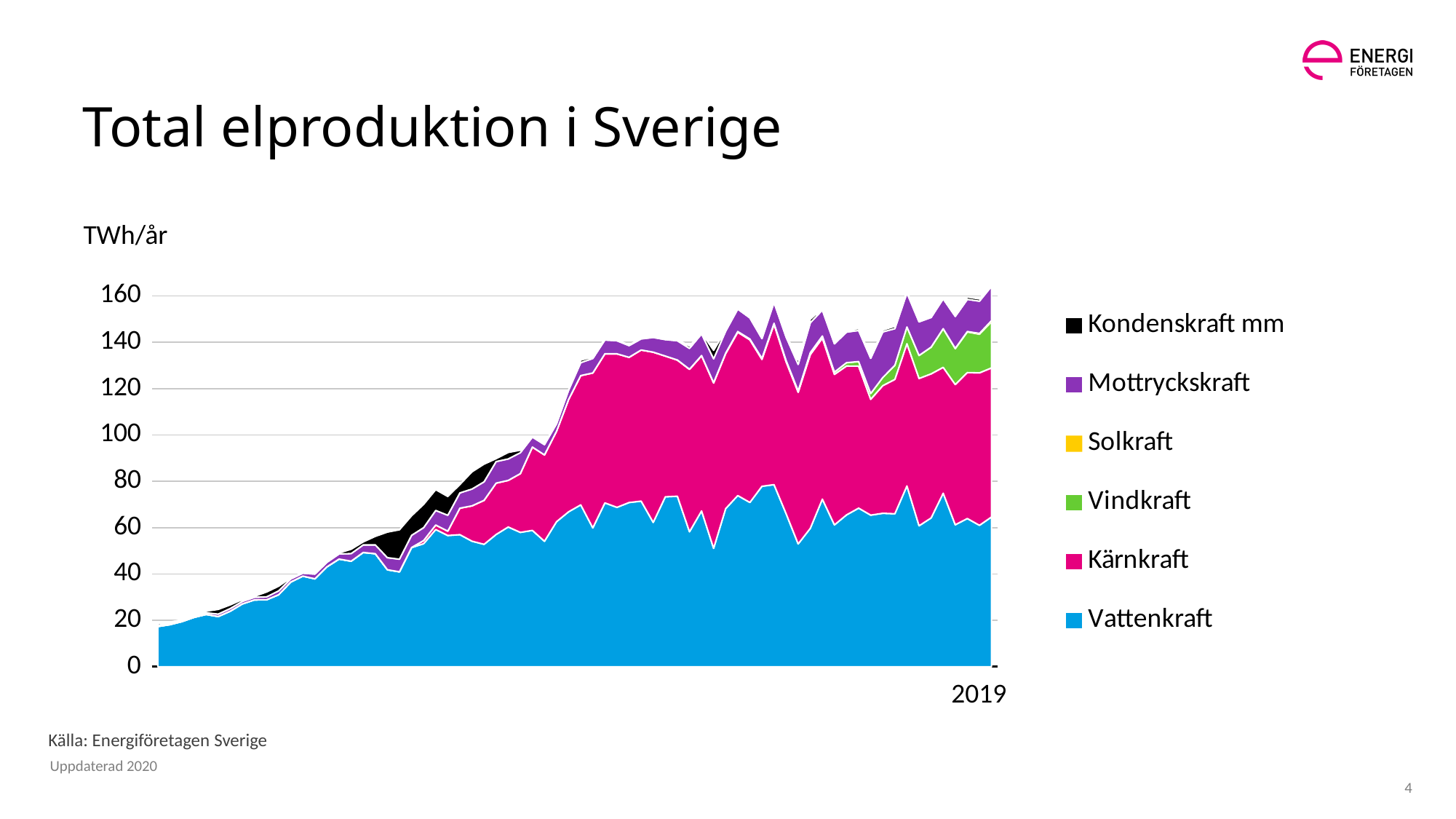
What is the last year labelled on the x axis? 2019 Is the value for Vattenkraft in 2019 greater or less than 80? less Is the total production in 2019 greater or less than 140? greater Does the total electricity production rise or fall overall from the left of the x axis to 2019? Rise Which series is plotted as the bottom layer of the stacked area chart? Vattenkraft Is the value for Vattenkraft in 2019 greater or less than 40? greater What kind of chart is shown on the slide? Stacked area chart How many series does the legend list? 6 What unit is shown on the y axis of the chart? TWh/år